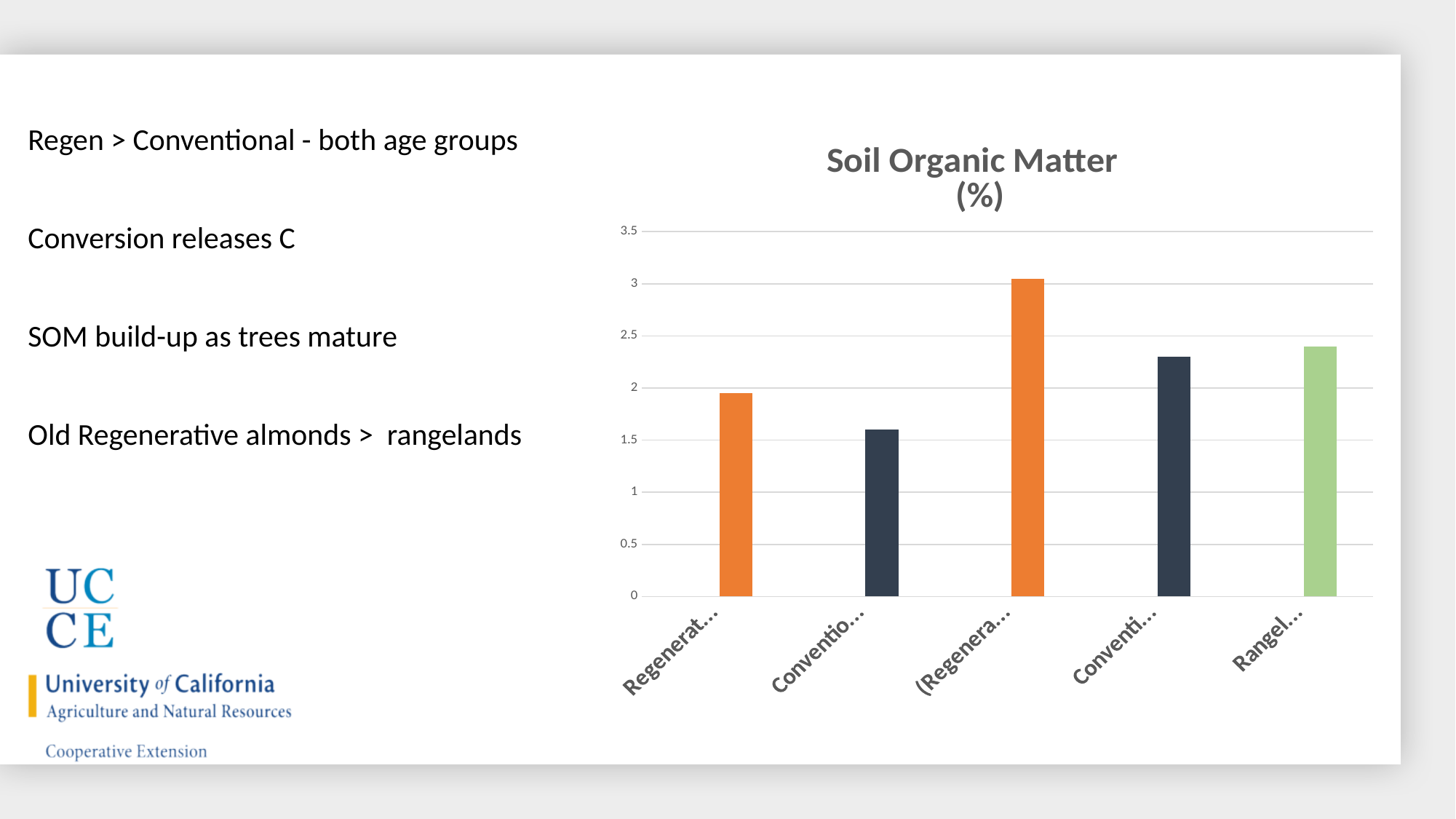
What is the title of the chart? Soil Organic Matter (%) Which is larger, the first bar from the left or the second bar from the left? the first bar Which bar, by position from the left, is the tallest in the chart? the third bar Is the value of the third bar from the left greater or less than 2.5? greater Is the value of the second bar from the left greater or less than 2? less Is the value of the first bar from the left greater or less than 1.5? greater What colour is the rightmost bar in the chart? green Which bar, by position from the left, is the shortest in the chart? the second bar Which is larger, the third bar from the left or the fifth bar from the left? the third bar How many bars are plotted in the chart? 5 What kind of chart is shown on the slide? bar chart